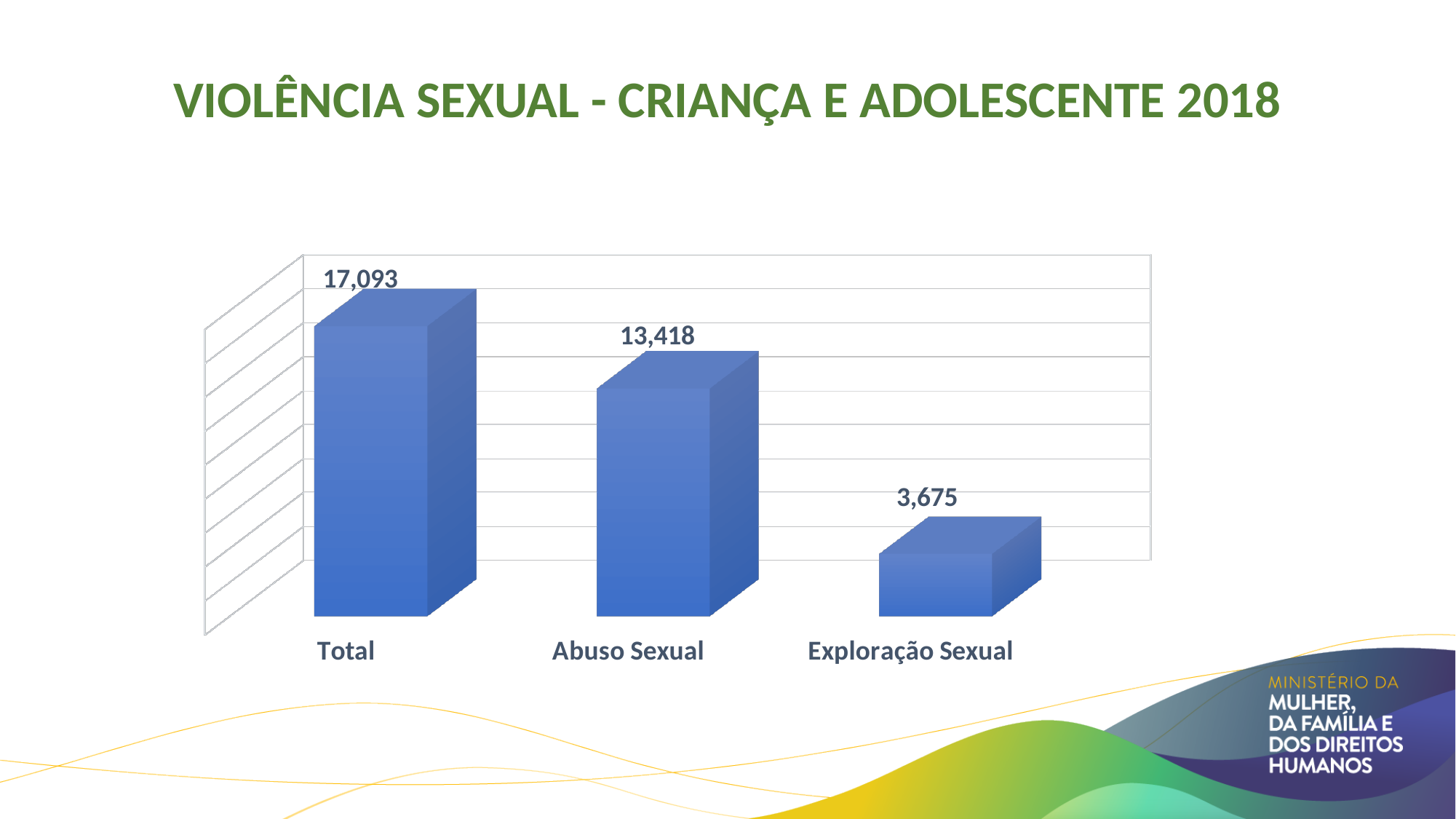
What is the value for Exploração Sexual? 3,675 Which category has the lowest value? Exploração Sexual Which category has the highest value? Total How many categories are shown in the chart? 3 What is the title of the chart on the slide? VIOLÊNCIA SEXUAL - CRIANÇA E ADOLESCENTE 2018 Which is larger, the value for Abuso Sexual or the value for Exploração Sexual? Abuso Sexual What is the difference between the values for Total and Abuso Sexual? 3,675 What is the value for Total? 17,093 Do the values rise or fall from left to right across the categories? Fall What is the value for Abuso Sexual? 13,418 What kind of chart is shown on the slide? Bar chart What is the difference between the values for Abuso Sexual and Exploração Sexual? 9,743